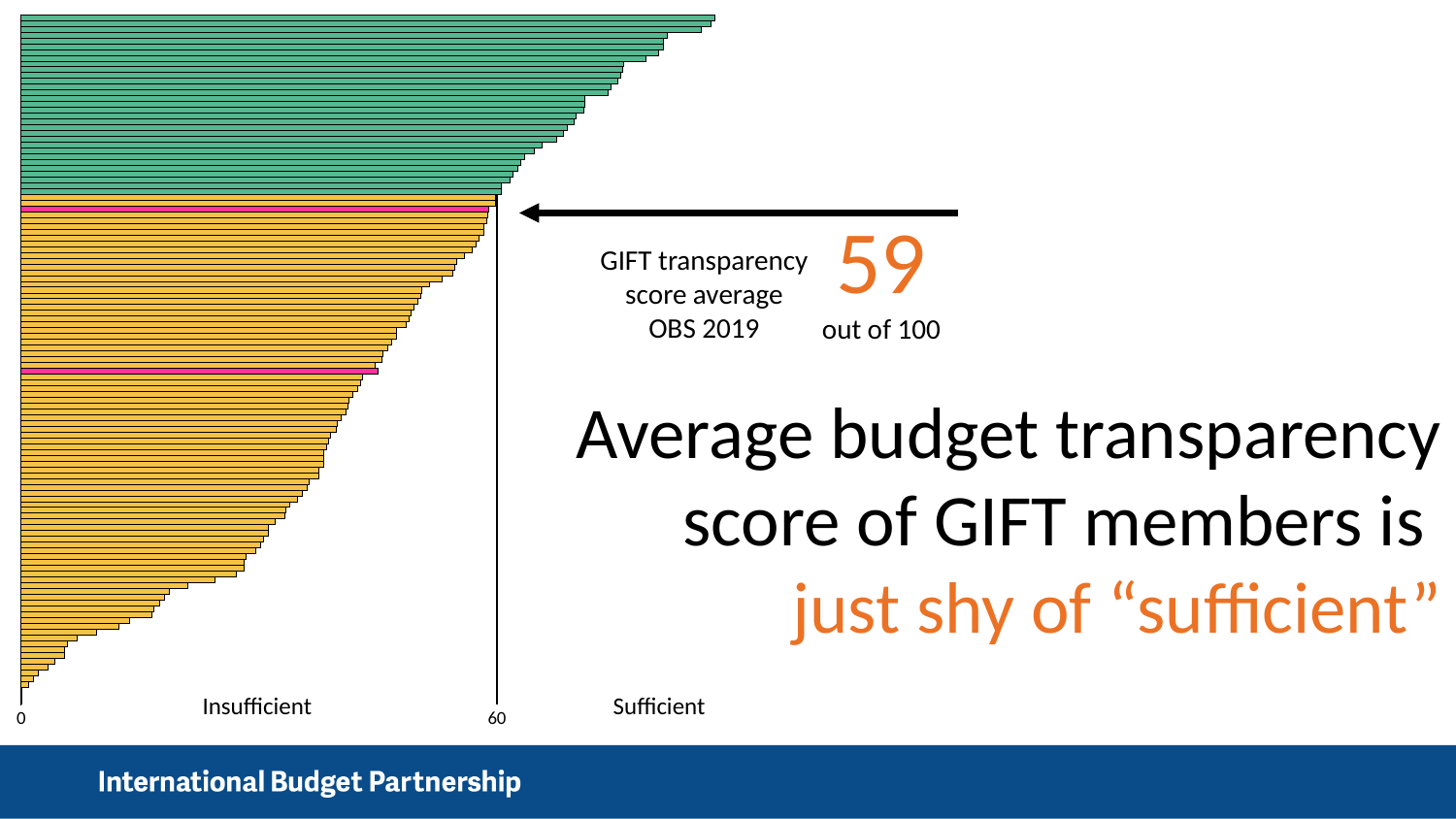
What value does the vertical line on the chart mark on the axis? 60 What is the GIFT transparency score average for OBS 2019 shown on the slide? 59 Do the bar lengths increase or decrease going from the top of the chart to the bottom? decrease Out of what maximum is the GIFT transparency score average of 59 measured? 100 What kind of chart is shown on the slide? Bar chart Is the GIFT transparency score average of 59 greater or less than the 60 threshold marked on the axis? less Are the green bars at the top of the chart greater or less than 60? greater What is the lowest value shown on the horizontal axis of the chart? 0 Are the yellow bars at the bottom of the chart greater or less than 60? less What label is given to the region of the chart to the right of the 60 line? Sufficient What label is given to the region of the chart to the left of the 60 line? Insufficient